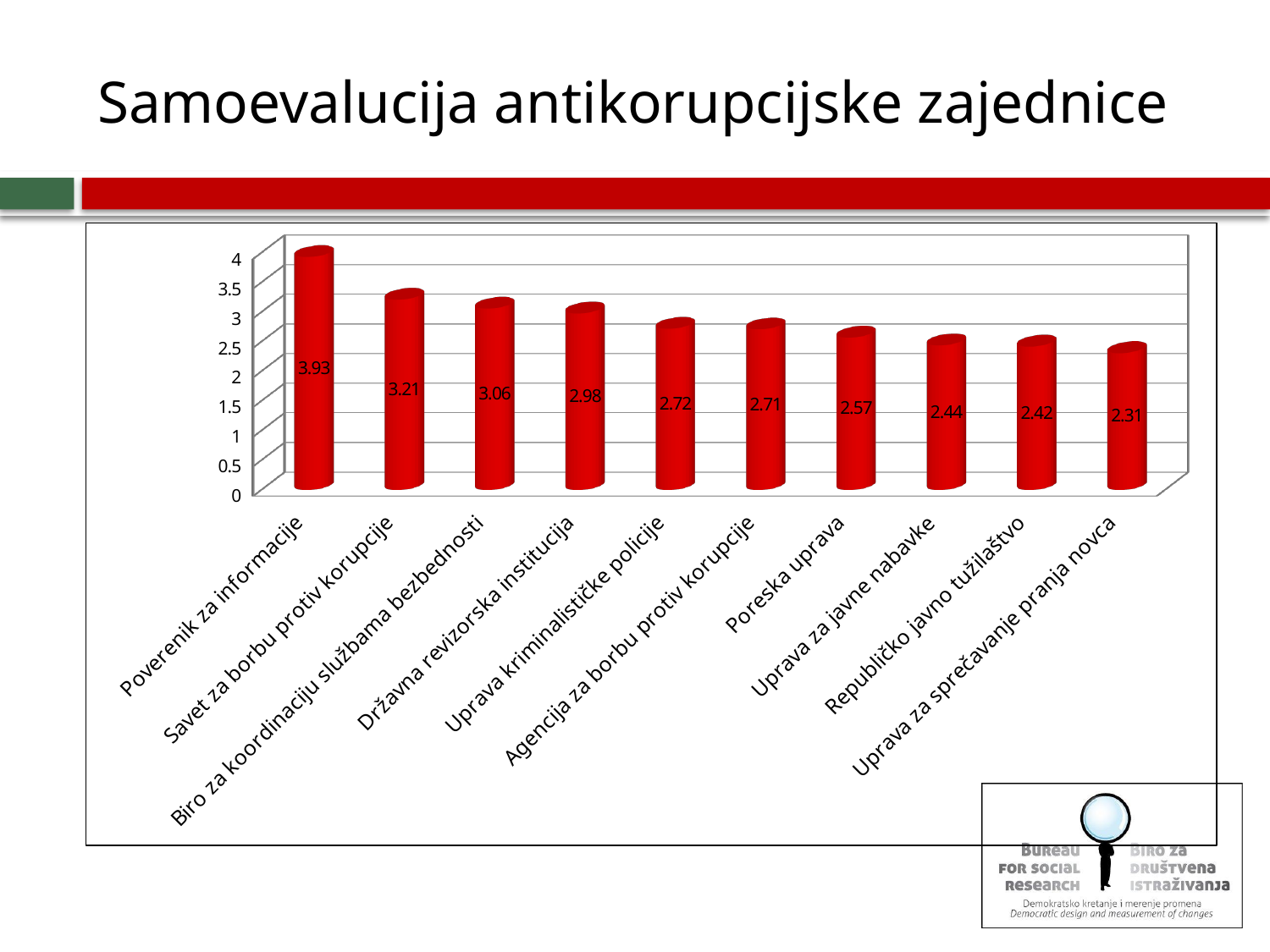
What is the value for Poreska uprava? 2.57 What is the difference between the values for Poverenik za informacije and Savet za borbu protiv korupcije? 0.72 Which is larger, the value for Državna revizorska institucija or the value for Uprava za javne nabavke? Državna revizorska institucija What is the title of the slide? Samoevalucija antikorupcijske zajednice What is the value for Republičko javno tužilaštvo? 2.42 How many categories are shown in the chart? 10 Do the values rise or fall from left to right along the x axis? fall What is the value for Poverenik za informacije? 3.93 Which category has the highest value? Poverenik za informacije Which category has the lowest value? Uprava za sprečavanje pranja novca What kind of chart is shown on the slide? bar chart Is the value for Biro za koordinaciju službama bezbednosti greater or less than 2.5? greater